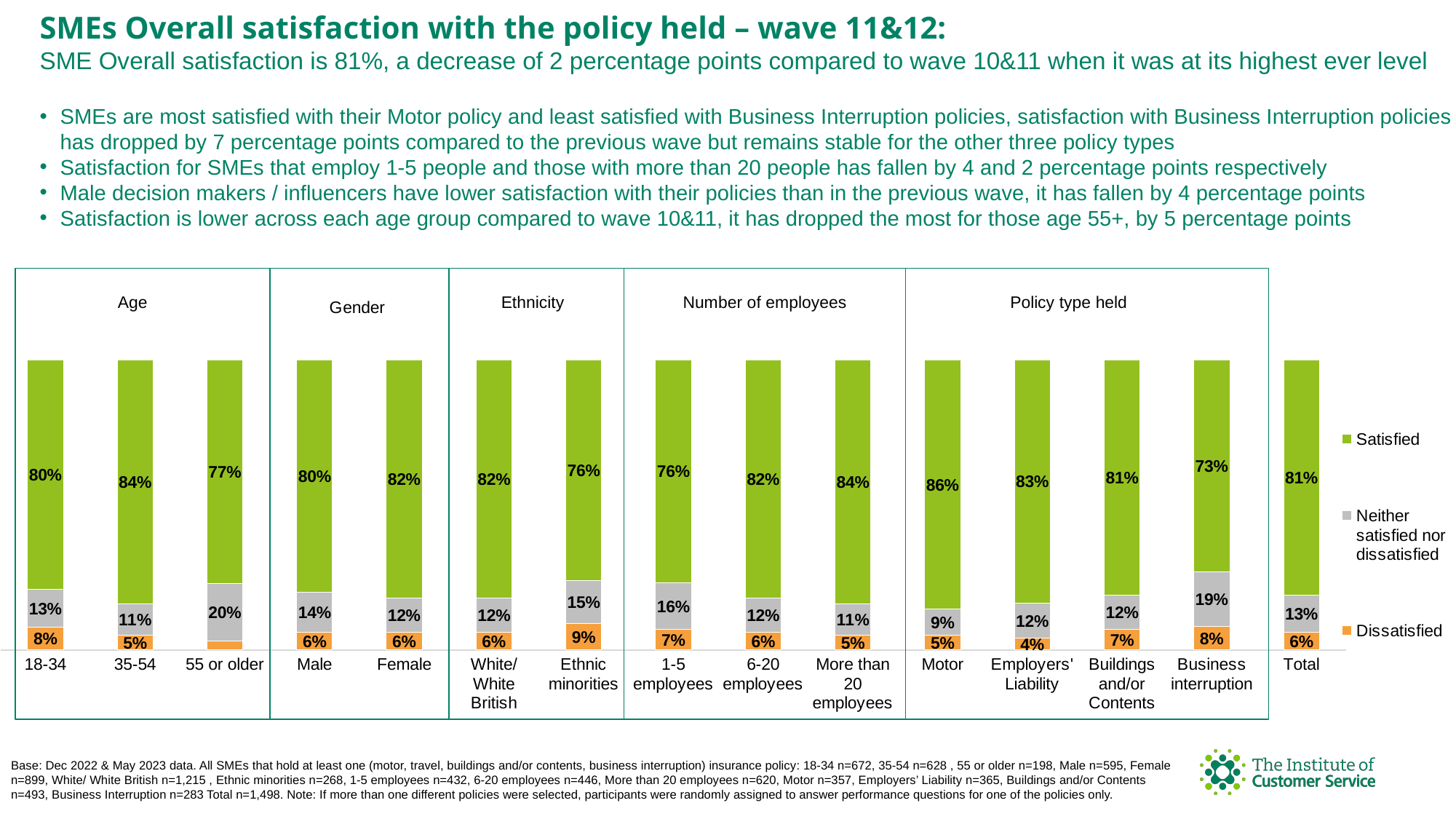
What percentage of SMEs aged 55 or older are satisfied with the policy held? 77% Which has a higher Satisfied percentage, Male or Female? Female Which policy type held has the highest Satisfied percentage? Motor What is the total of the three segments for the Total bar? 100% What is the Dissatisfied percentage for Ethnic minorities? 9% What is the difference in Satisfied percentage between 1-5 employees and More than 20 employees? 8 percentage points How many series does the legend list? 3 Which category has the lowest Satisfied percentage across the whole chart? Business interruption How many categories (bars) are shown in the chart? 15 Which colour represents the Dissatisfied series in the chart? Orange What kind of chart is shown on the slide? Stacked bar chart What is the 'Neither satisfied nor dissatisfied' percentage for Business interruption policies? 19%